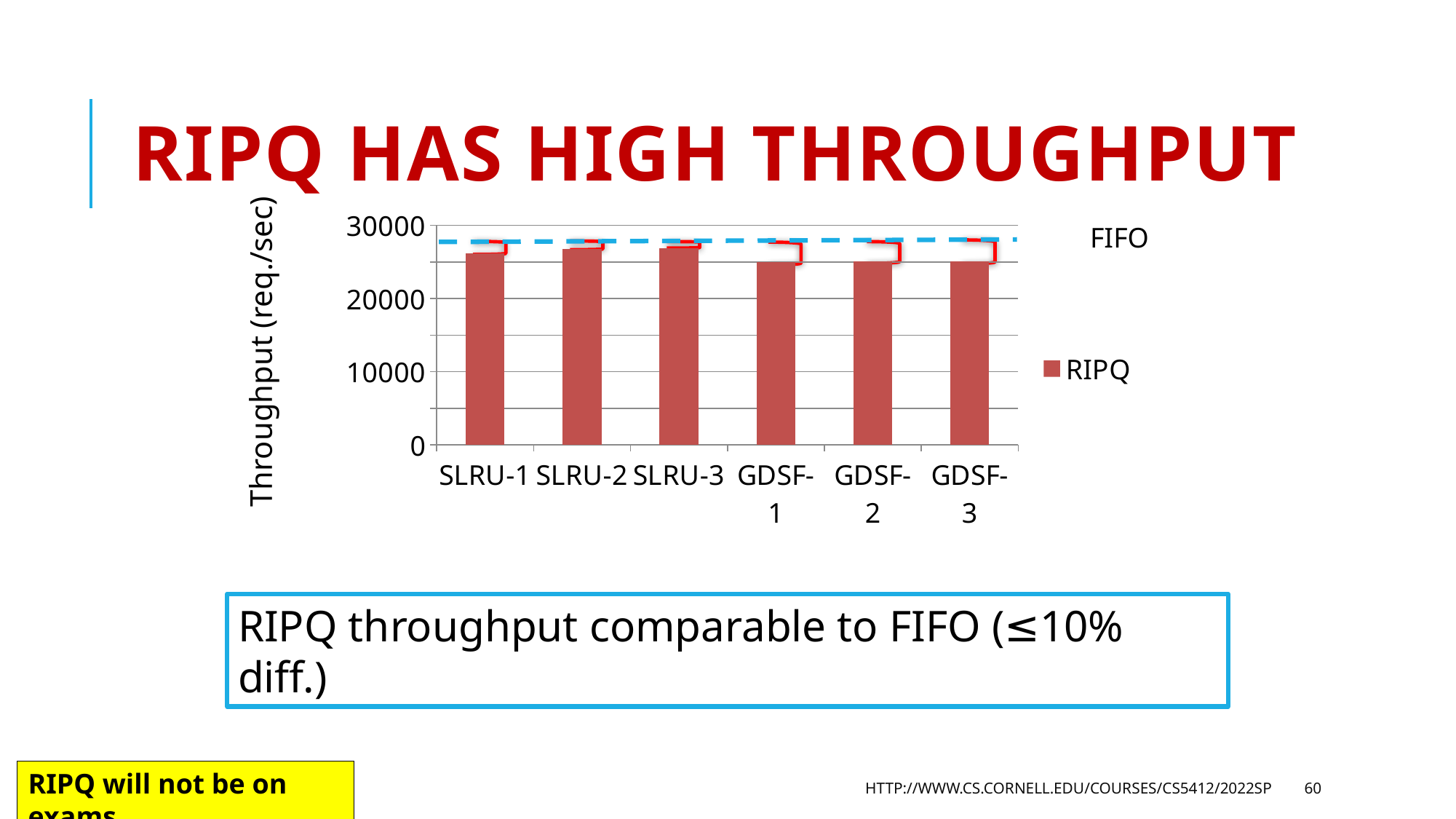
Is the RIPQ throughput for SLRU-2 greater or less than 30000? less Is the RIPQ throughput for SLRU-3 greater or less than 10000? greater Is the RIPQ throughput for GDSF-3 greater or less than 20000? greater How many categories are shown on the x axis of the chart? 6 What kind of chart is shown on the slide? bar chart How many series does the chart's legend list? 1 What does the dashed horizontal line on the chart represent? FIFO What is the label of the y axis of the chart? Throughput (req./sec)